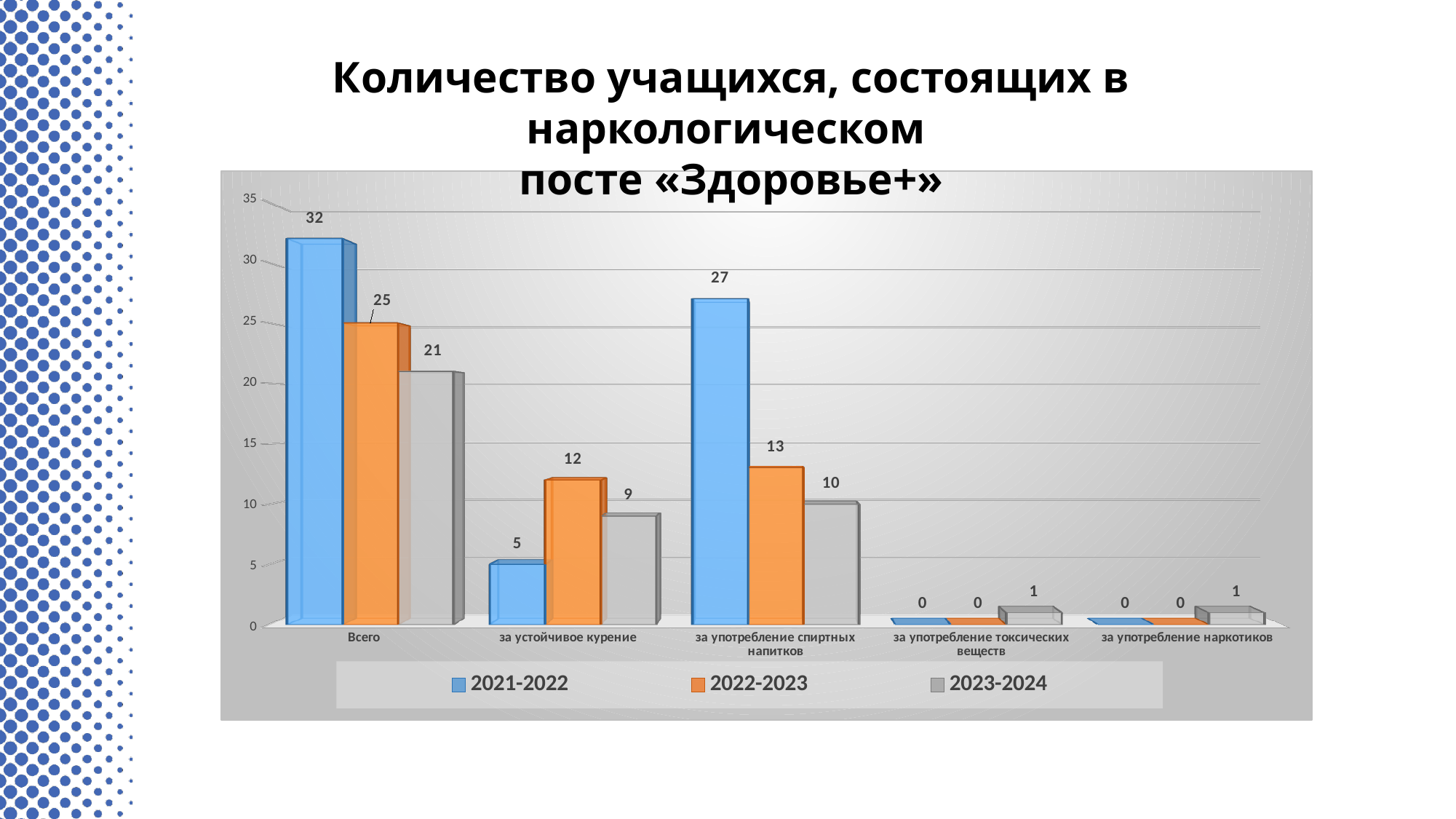
What kind of chart is shown on the slide? bar chart Which colour represents the 2022-2023 series in the legend? orange Which category has the lowest value for the 2021-2022 series (excluding ties)? Name one of the categories with value 0. за употребление токсических веществ What is the difference between the 2021-2022 and 2023-2024 values in the 'Всего' category? 11 What is the value for 2022-2023 in the 'за употребление спиртных напитков' category? 13 Which series has the highest value in the 'за устойчивое курение' category? 2022-2023 How many series does the legend list? 3 What is the value for 2023-2024 in the 'за употребление наркотиков' category? 1 What is the value for 2021-2022 in the 'Всего' category? 32 Which is larger: the 2021-2022 value for 'за употребление спиртных напитков' or the 2022-2023 value for 'Всего'? 2021-2022 value for 'за употребление спиртных напитков' What is the value for 2023-2024 in the 'за устойчивое курение' category? 9 How many categories are shown on the x axis? 5